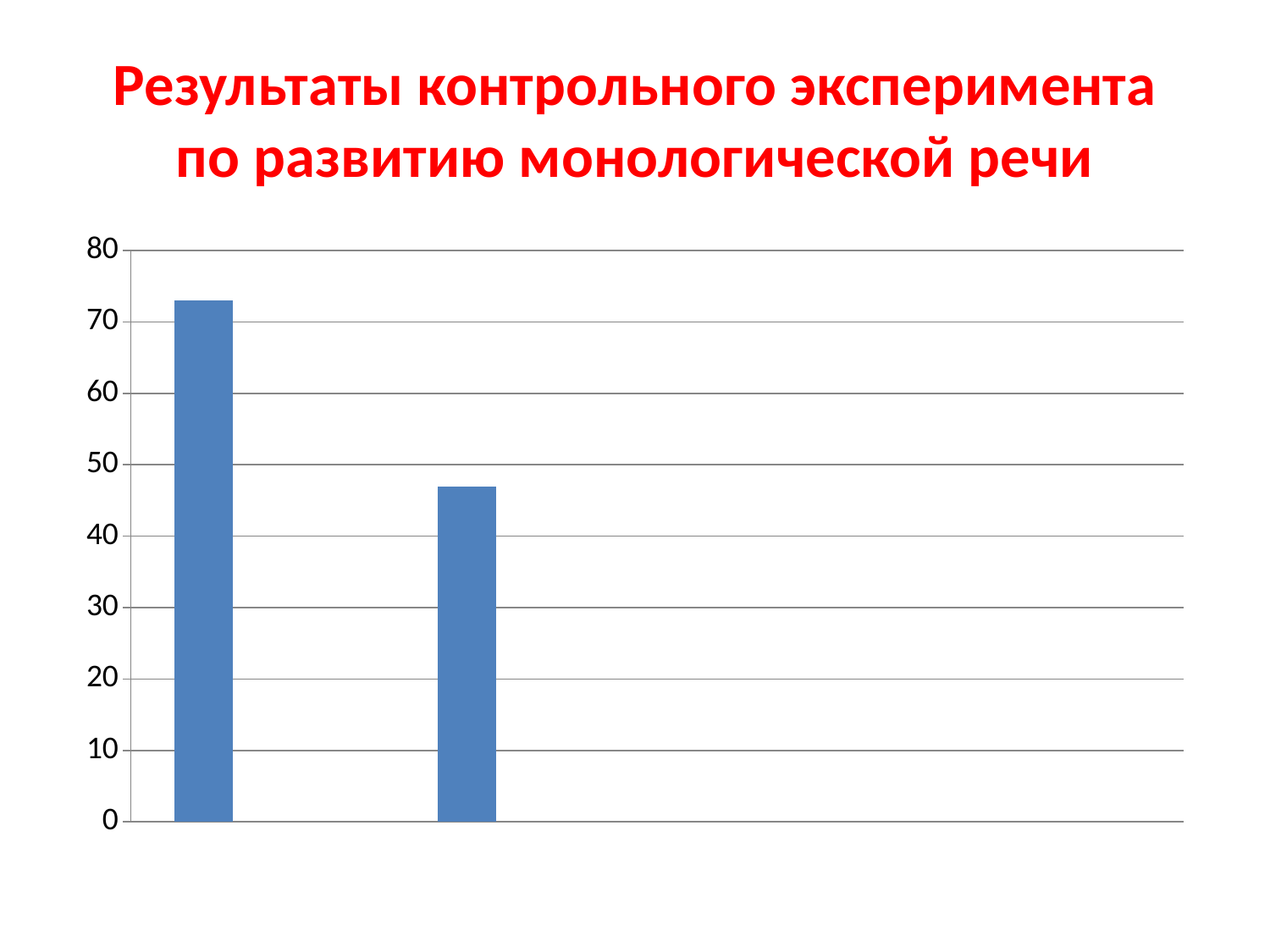
Is the value of the left bar greater or less than 70? greater Which bar is taller, the left one or the right one? the left one What kind of chart is shown on the slide? bar chart Which bar has the lowest value, the left one or the right one? the right one Is the value of the right bar greater or less than 40? greater Do the bar values rise or fall from left to right? fall Is the value of the left bar greater or less than 80? less How many bars are plotted in the chart? 2 What is the highest value shown on the vertical axis? 80 What is the title of the slide containing the chart? Результаты контрольного эксперимента по развитию монологической речи